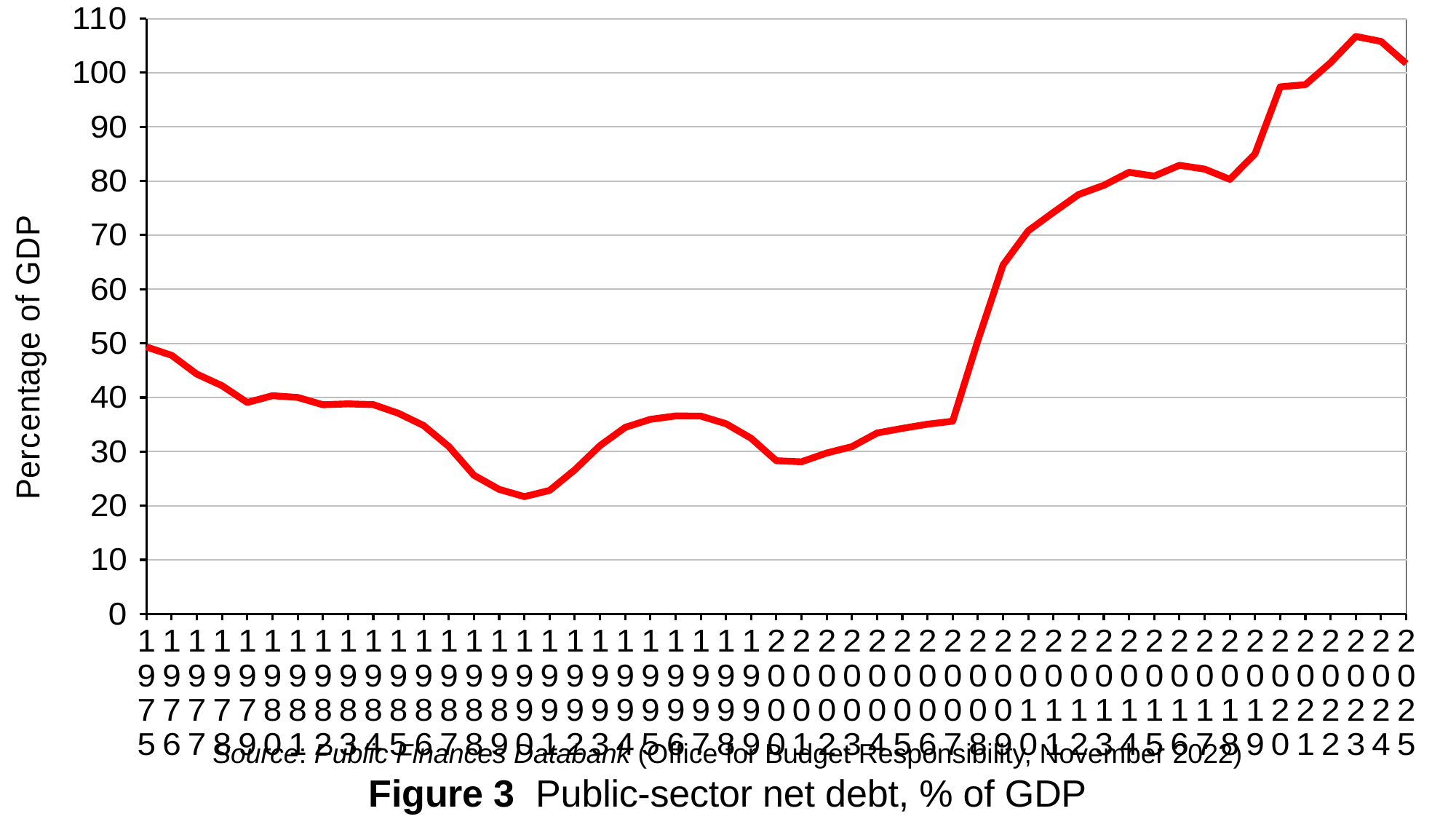
In which year does public-sector net debt reach its highest value? 2023 What kind of chart is shown on the slide? line chart How many years are plotted on the x axis? 51 Which year has the higher value, 1990 or 2000? 2000 What is the label on the vertical axis? Percentage of GDP Is the value for 2023 greater or less than 100? greater Is the value for 1990 greater or less than 30? less In which year does public-sector net debt reach its lowest value? 1990 Is the value for 2020 greater or less than 90? greater Does public-sector net debt rise or fall between 2008 and 2010? rise What is the title of the chart? Figure 3 Public-sector net debt, % of GDP